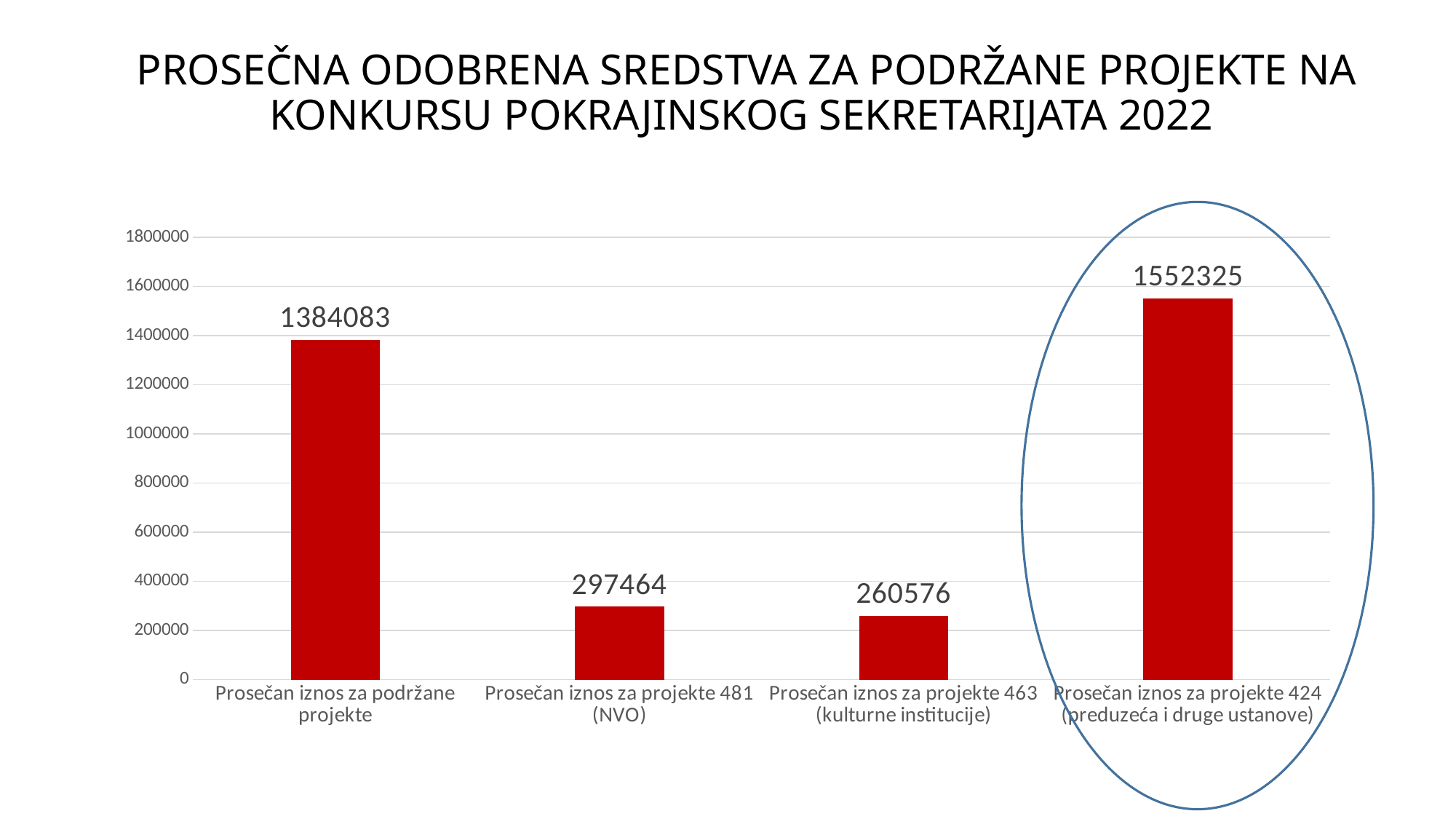
Which is larger: the value for 'Prosečan iznos za projekte 481 (NVO)' or the value for 'Prosečan iznos za projekte 463 (kulturne institucije)'? Prosečan iznos za projekte 481 (NVO) What is the difference between the value for 'Prosečan iznos za projekte 481 (NVO)' and the value for 'Prosečan iznos za projekte 463 (kulturne institucije)'? 36888 How many categories are shown in the chart? 4 What is the value for 'Prosečan iznos za podržane projekte'? 1384083 What is the difference between the value for 'Prosečan iznos za projekte 424 (preduzeća i druge ustanove)' and the value for 'Prosečan iznos za podržane projekte'? 168242 Which category has the highest value? Prosečan iznos za projekte 424 (preduzeća i druge ustanove) What is the value for 'Prosečan iznos za projekte 463 (kulturne institucije)'? 260576 Is the value for 'Prosečan iznos za podržane projekte' greater or less than 1000000? greater What is the value for 'Prosečan iznos za projekte 481 (NVO)'? 297464 What is the value for 'Prosečan iznos za projekte 424 (preduzeća i druge ustanove)'? 1552325 What kind of chart is shown on the slide? bar chart Which category has the lowest value? Prosečan iznos za projekte 463 (kulturne institucije)